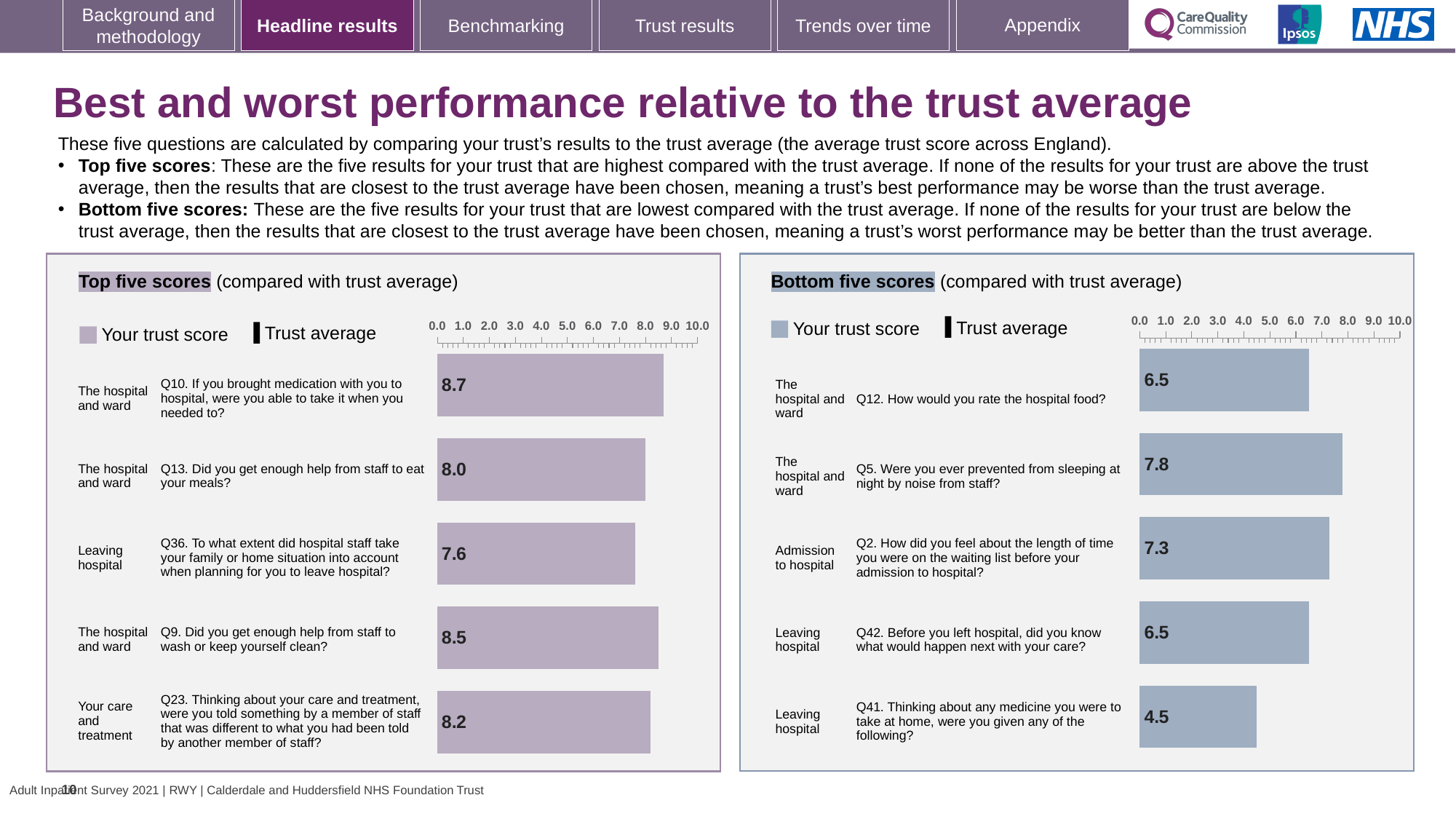
In the Top five scores chart, what is the difference between the scores for Q10 and Q36? 1.1 In the Bottom five scores chart, what is the difference between the scores for Q5 and Q41? 3.3 In the Top five scores chart, which question has the lowest trust score? Q36 In the Bottom five scores chart, which question has the highest trust score? Q5 In the Bottom five scores chart, what is the trust score for Q41 (medicine to take at home)? 4.5 In the Top five scores chart, what is the trust score for Q13 (Did you get enough help from staff to eat your meals?)? 8.0 In the Bottom five scores chart, which question has the lowest trust score? Q41 In the Bottom five scores chart, what is the trust score for Q2 (length of time on the waiting list before admission)? 7.3 In the Top five scores chart, which question has the highest trust score? Q10 What type of chart is used in the Bottom five scores panel? Bar chart In the Top five scores chart, which has the higher trust score, Q9 or Q23? Q9 How many series does the legend of the Top five scores chart list? 2